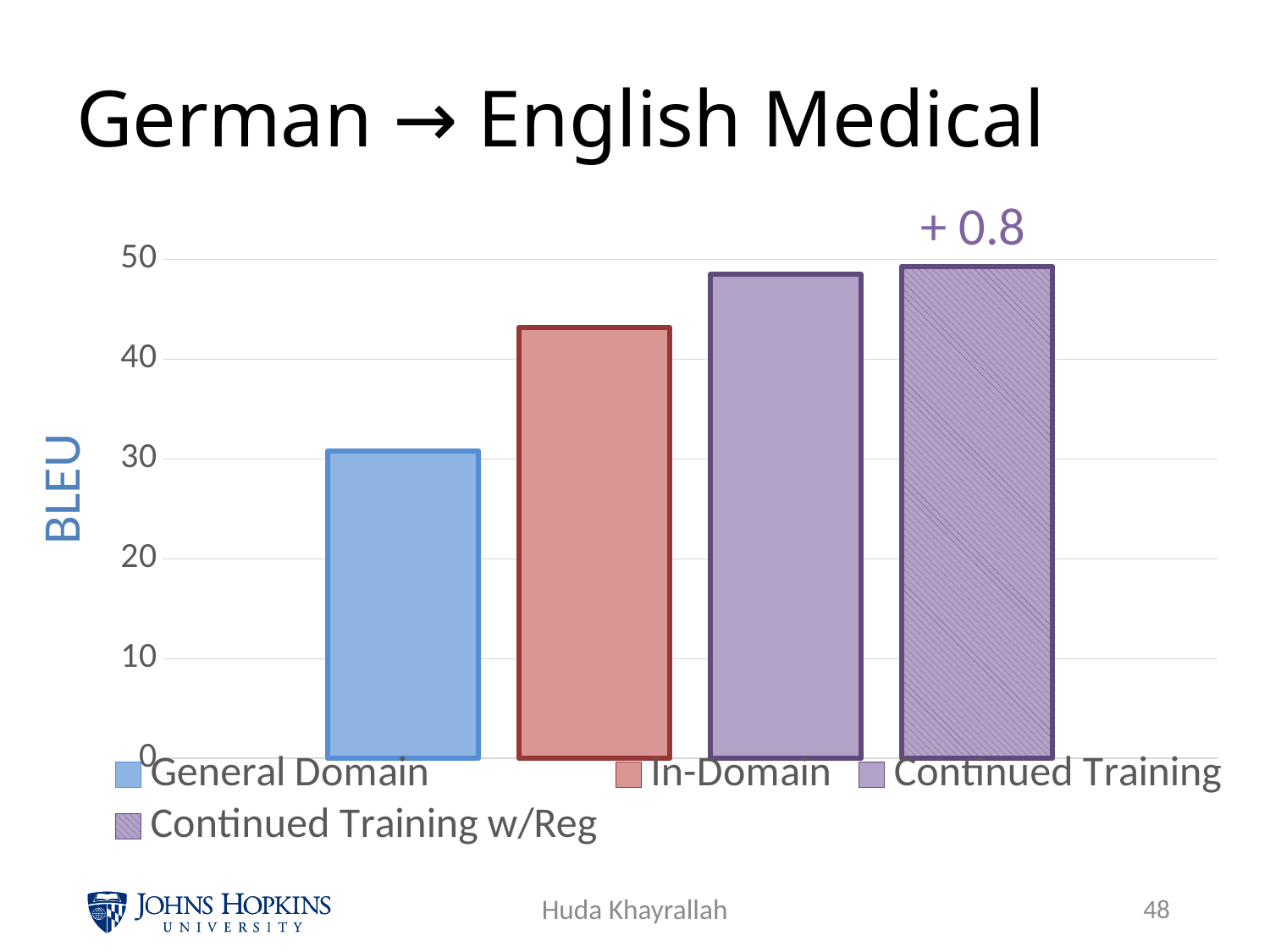
Which is larger, the BLEU score for In-Domain or for General Domain? In-Domain How many series does the legend list? 4 Is the BLEU value for General Domain greater or less than 40? less What kind of chart is shown on the slide? bar chart Do the BLEU values rise or fall moving from left to right across the bars? rise How many bars are plotted in the chart? 4 Which series has the lowest BLEU score? General Domain What is the label on the vertical axis? BLEU What annotation is printed above the Continued Training w/Reg bar? + 0.8 Is the BLEU value for Continued Training greater or less than 50? less Is the BLEU value for In-Domain greater or less than 40? greater Which is larger, the BLEU score for Continued Training or for In-Domain? Continued Training